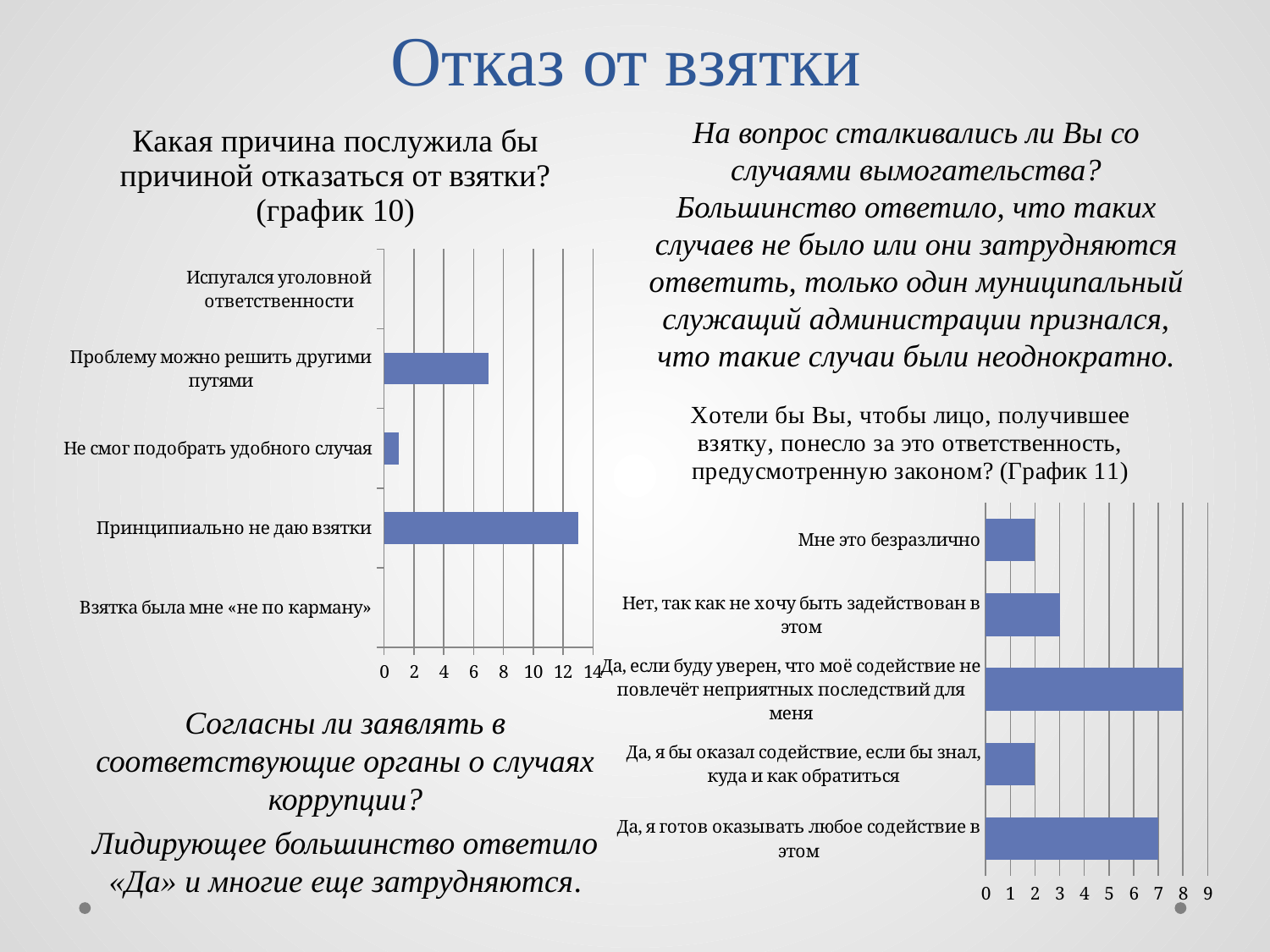
In the chart "График 11" on the right, what is the value for "Да, я готов оказывать любое содействие в этом"? 7 In the chart "график 10" on the left, which category has the highest value? Принципиально не даю взятки In the chart "график 10" on the left, how many categories are listed on the vertical axis? 5 What kind of chart is the chart titled "график 10" on the left of the slide? bar chart In the chart "график 10" on the left, is the value for "Проблему можно решить другими путями" greater or less than 8? less In the chart "График 11" on the right, what is the difference between the value for "Да, если буду уверен, что моё содействие не повлечёт неприятных последствий для меня" and the value for "Мне это безразлично"? 6 In the chart "график 10" on the left, which is larger: the value for "Проблему можно решить другими путями" or the value for "Не смог подобрать удобного случая"? Проблему можно решить другими путями In the chart "График 11" on the right, which category has the highest value? Да, если буду уверен, что моё содействие не повлечёт неприятных последствий для меня In the chart "график 10" on the left, is the value for "Принципиально не даю взятки" greater or less than 12? greater In the chart "График 11" on the right, how many categories are listed on the vertical axis? 5 In the chart "График 11" on the right, what is the value for "Да, если буду уверен, что моё содействие не повлечёт неприятных последствий для меня"? 8 In the chart "График 11" on the right, what is the value for "Нет, так как не хочу быть задействован в этом"? 3